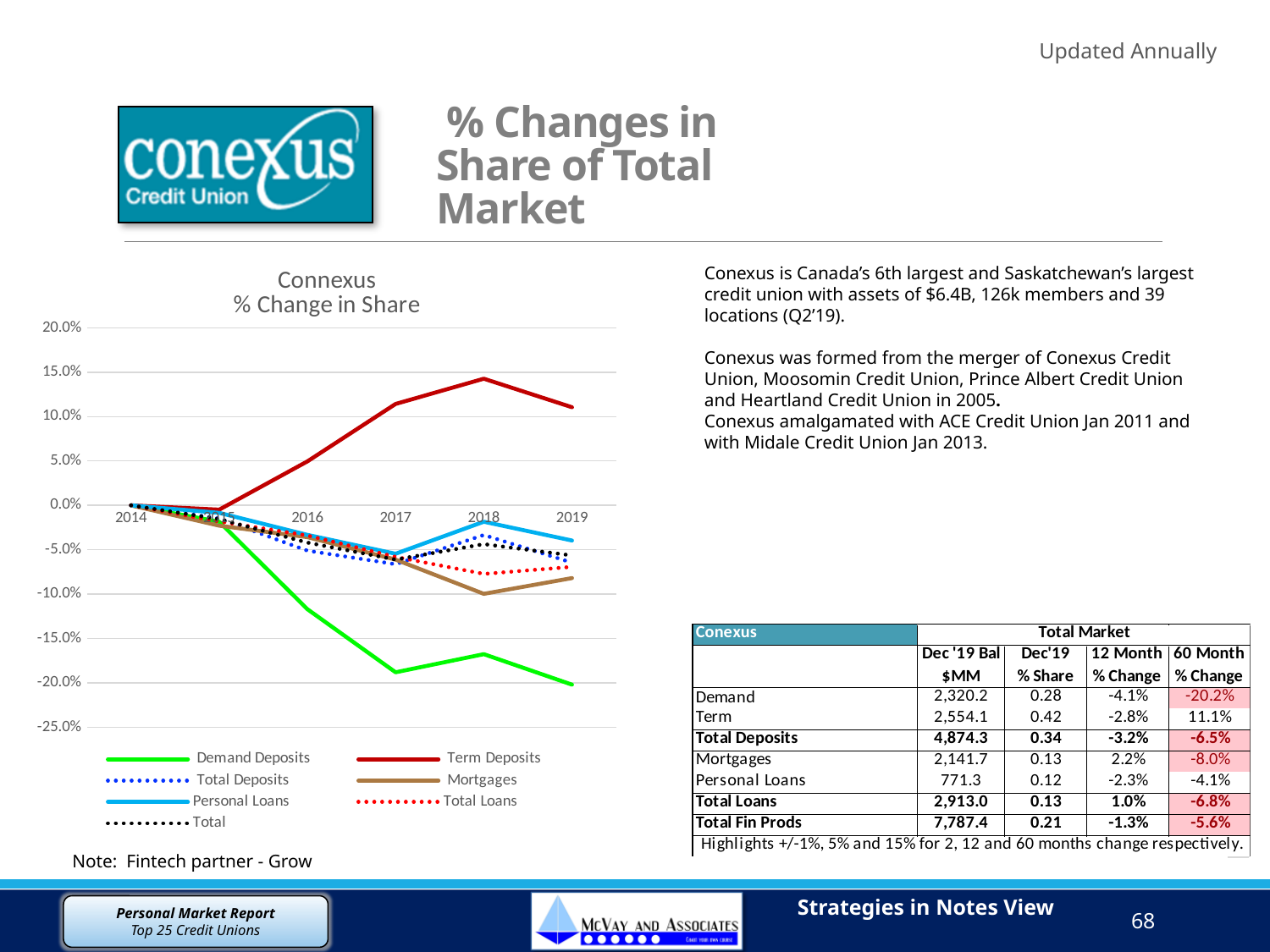
How many years are plotted along the x axis of the chart? 6 Which series has the highest value in 2019? Term Deposits What is the title of the chart? Connexus % Change in Share Does the Term Deposits line rise or fall from 2014 to 2018? rise Does the Demand Deposits line rise or fall from 2014 to 2019? fall Is the value for Demand Deposits in 2017 greater or less than -15.0%? less In 2018, which is larger: Term Deposits or Demand Deposits? Term Deposits Is the value for Demand Deposits in 2019 greater or less than -15.0%? less What kind of chart is shown on the slide? line chart How many series does the legend of the "Connexus % Change in Share" chart list? 7 Is the value for Term Deposits in 2018 greater or less than 10.0%? greater Which series has the lowest value in 2019? Demand Deposits